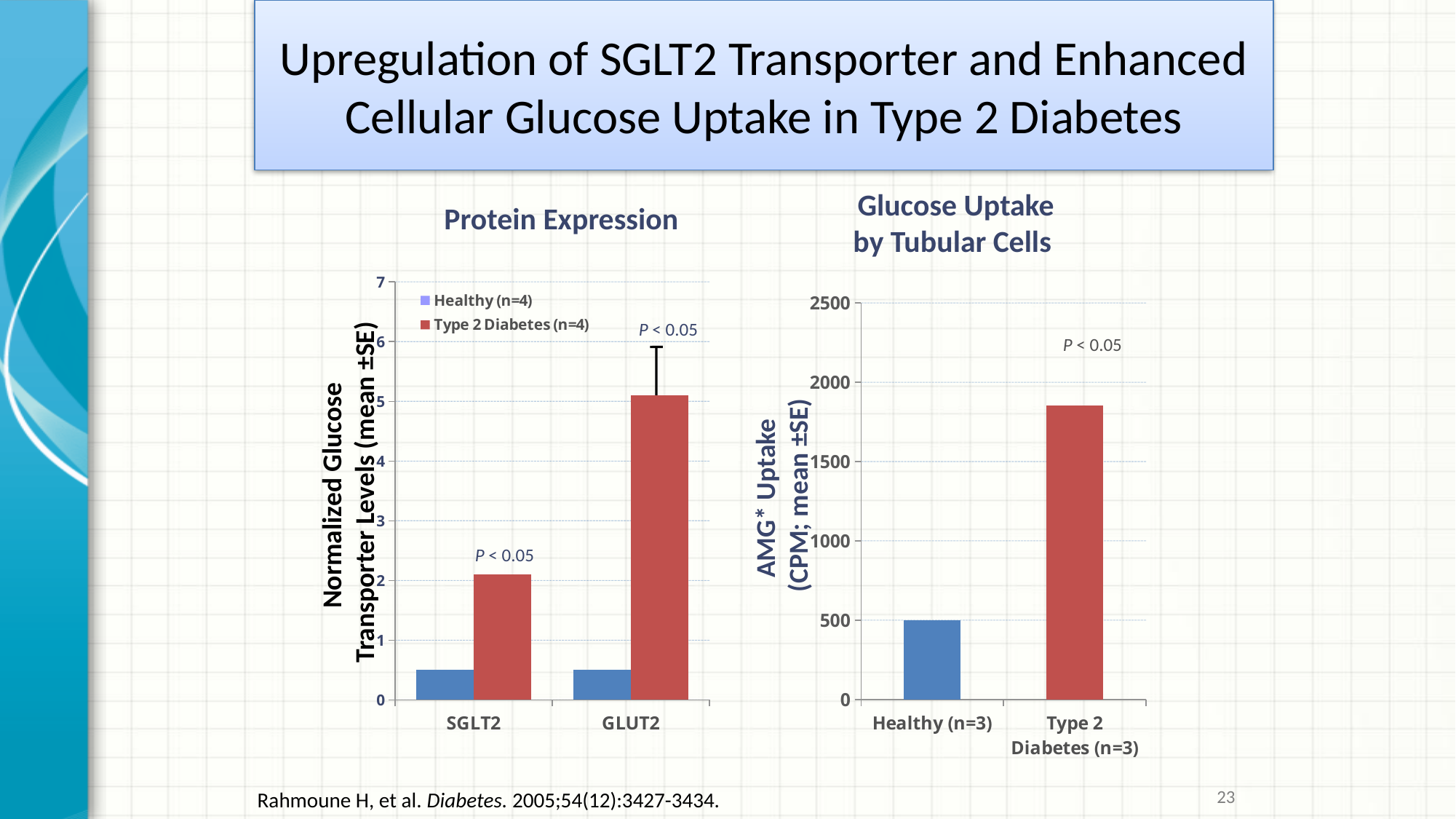
In the Glucose Uptake by Tubular Cells chart, which category has the highest value? Type 2 Diabetes (n=3) In the Protein Expression chart, what are the two legend entries? Healthy (n=4) and Type 2 Diabetes (n=4) In the Protein Expression chart, which category has the higher Type 2 Diabetes (n=4) value? GLUT2 In the Protein Expression chart, how many categories are shown on the x axis? 2 In the Protein Expression chart, how many series does the legend list? 2 In the Protein Expression chart, for SGLT2, which series has the larger value: Healthy (n=4) or Type 2 Diabetes (n=4)? Type 2 Diabetes (n=4) In the Glucose Uptake by Tubular Cells chart, is the value for Healthy (n=3) greater or less than 1000? less In the Glucose Uptake by Tubular Cells chart, how many categories are shown? 2 In the Protein Expression chart, is the Type 2 Diabetes (n=4) value for SGLT2 greater or less than 3? less In the Glucose Uptake by Tubular Cells chart, is the value for Type 2 Diabetes (n=3) greater or less than 1500? greater In the Protein Expression chart, what kind of chart is shown? bar chart